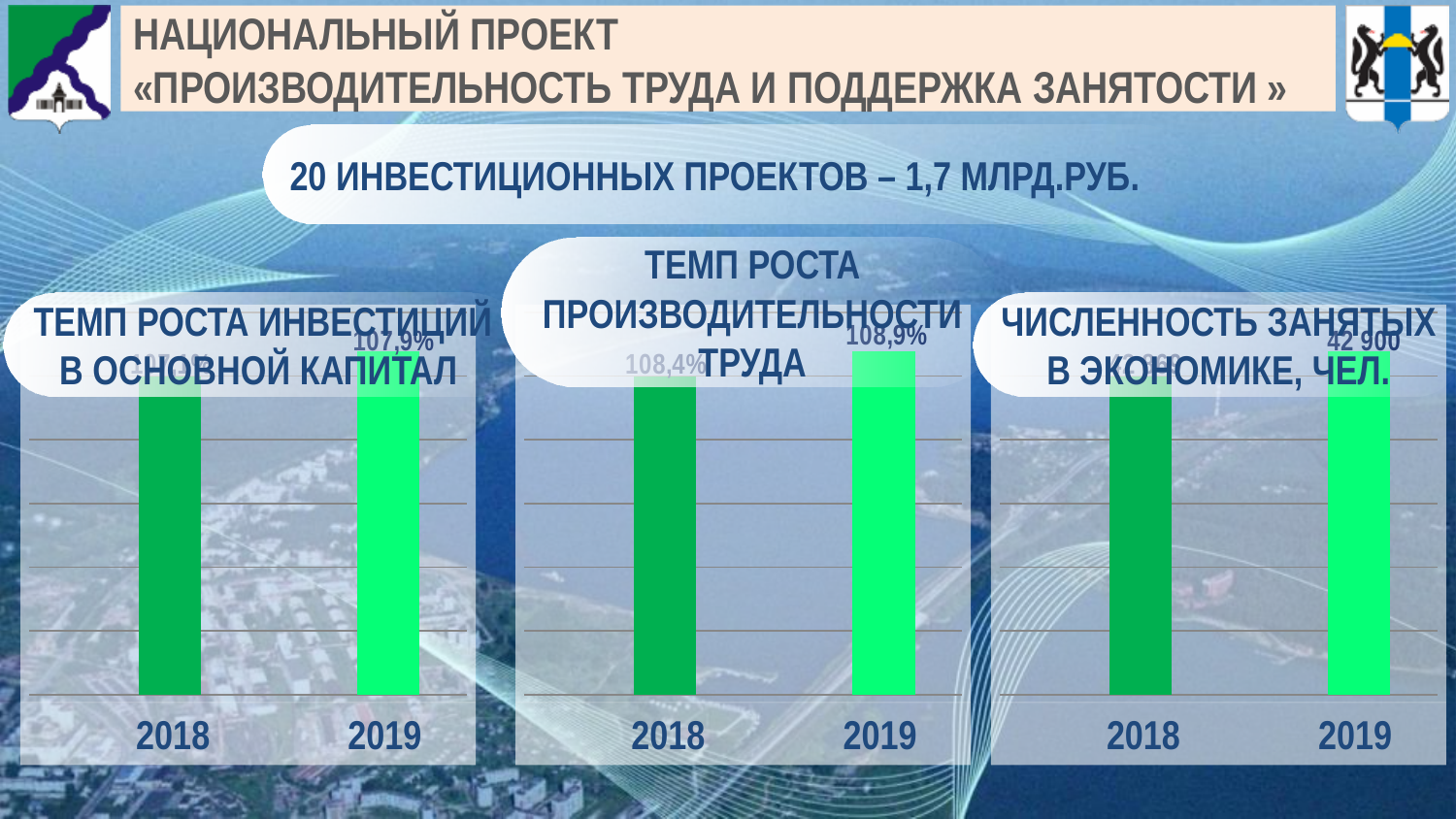
In the chart titled «ТЕМП РОСТА ПРОИЗВОДИТЕЛЬНОСТИ ТРУДА», which year has the highest value? 2019 What kind of chart is the chart titled «ЧИСЛЕННОСТЬ ЗАНЯТЫХ В ЭКОНОМИКЕ, ЧЕЛ.»? Bar chart In the chart titled «ТЕМП РОСТА ИНВЕСТИЦИЙ В ОСНОВНОЙ КАПИТАЛ», what is the value for 2019? 107,9% In the chart titled «ТЕМП РОСТА ПРОИЗВОДИТЕЛЬНОСТИ ТРУДА», what is the value for 2019? 108,9% In the chart titled «ТЕМП РОСТА ПРОИЗВОДИТЕЛЬНОСТИ ТРУДА», do the values rise or fall from 2018 to 2019? Rise In the chart titled «ЧИСЛЕННОСТЬ ЗАНЯТЫХ В ЭКОНОМИКЕ, ЧЕЛ.», which year has the taller bar, 2018 or 2019? 2019 In the chart titled «ТЕМП РОСТА ПРОИЗВОДИТЕЛЬНОСТИ ТРУДА», which year has the higher value, 2018 or 2019? 2019 In the chart titled «ТЕМП РОСТА ПРОИЗВОДИТЕЛЬНОСТИ ТРУДА», what is the value for 2018? 108,4% In the chart titled «ЧИСЛЕННОСТЬ ЗАНЯТЫХ В ЭКОНОМИКЕ, ЧЕЛ.», what is the value for 2019? 42 900 In the chart titled «ТЕМП РОСТА ПРОИЗВОДИТЕЛЬНОСТИ ТРУДА», by how much does the 2019 value exceed the 2018 value? 0,5 percentage points How many categories (years) are shown in the chart titled «ТЕМП РОСТА ИНВЕСТИЦИЙ В ОСНОВНОЙ КАПИТАЛ»? 2 How many charts are shown on the slide? 3